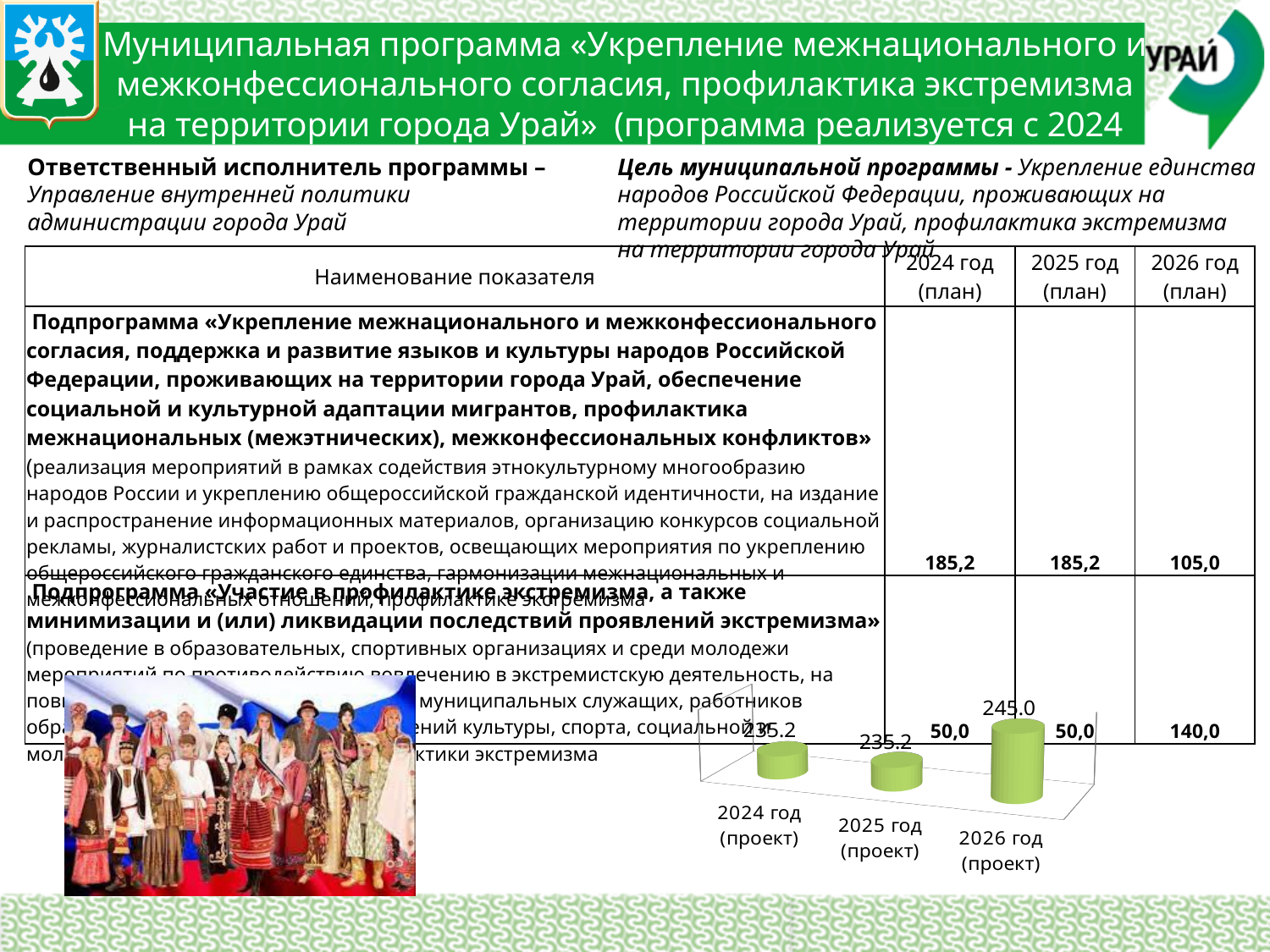
Which year has the highest value in the bar chart? 2026 год (проект) Do the values in the bar chart rise or fall from 2024 to 2026? rise What is the value for 2025 год (проект) in the bar chart? 235.2 How many categories are shown in the bar chart? 3 What is the difference between the values for 2026 год (проект) and 2024 год (проект) in the bar chart? 9.8 What colour are the bars in the chart? green What is the value for 2026 год (проект) in the bar chart? 245.0 What is the value for 2024 год (проект) in the bar chart? 235.2 Are the values for 2024 год (проект) and 2025 год (проект) in the bar chart equal? yes What kind of chart is shown on the slide? bar chart Which is larger in the bar chart: the value for 2026 год (проект) or the value for 2025 год (проект)? 2026 год (проект)